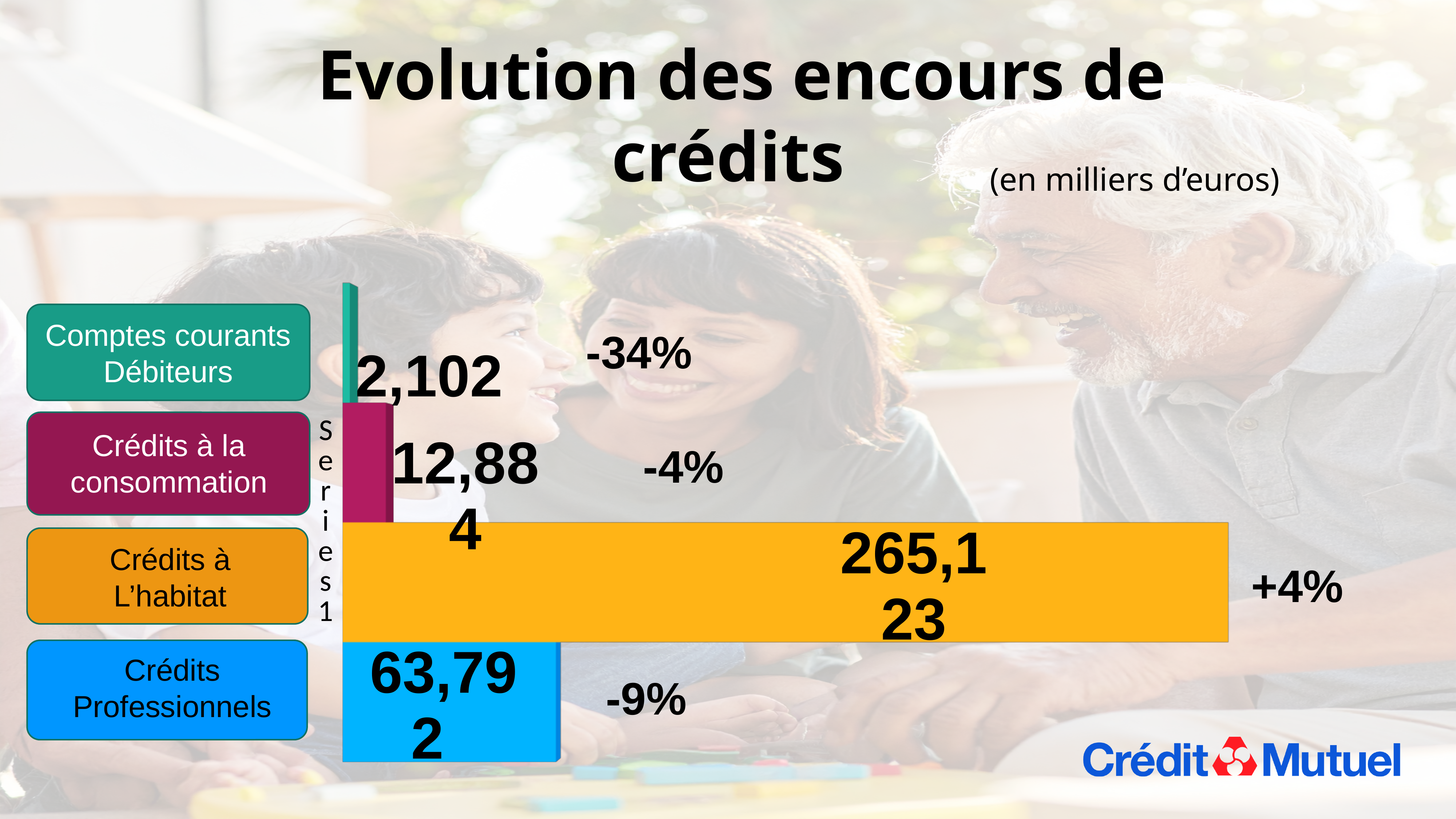
What is the value for Crédits Professionnels? 63,792 What kind of chart is shown on the slide? Bar chart What is the value for Crédits à L'habitat? 265,123 What is the title of the chart? Evolution des encours de crédits How many categories are shown in the chart? 4 Which is larger, the value for Crédits Professionnels or the value for Crédits à la consommation? Crédits Professionnels What percentage change is shown next to Comptes courants Débiteurs? -34% What is the difference between the values for Crédits à L'habitat and Crédits Professionnels? 201,331 What is the value for Crédits à la consommation? 12,884 Which category has the lowest value? Comptes courants Débiteurs What is the value for Comptes courants Débiteurs? 2,102 Which category has the highest value? Crédits à L'habitat